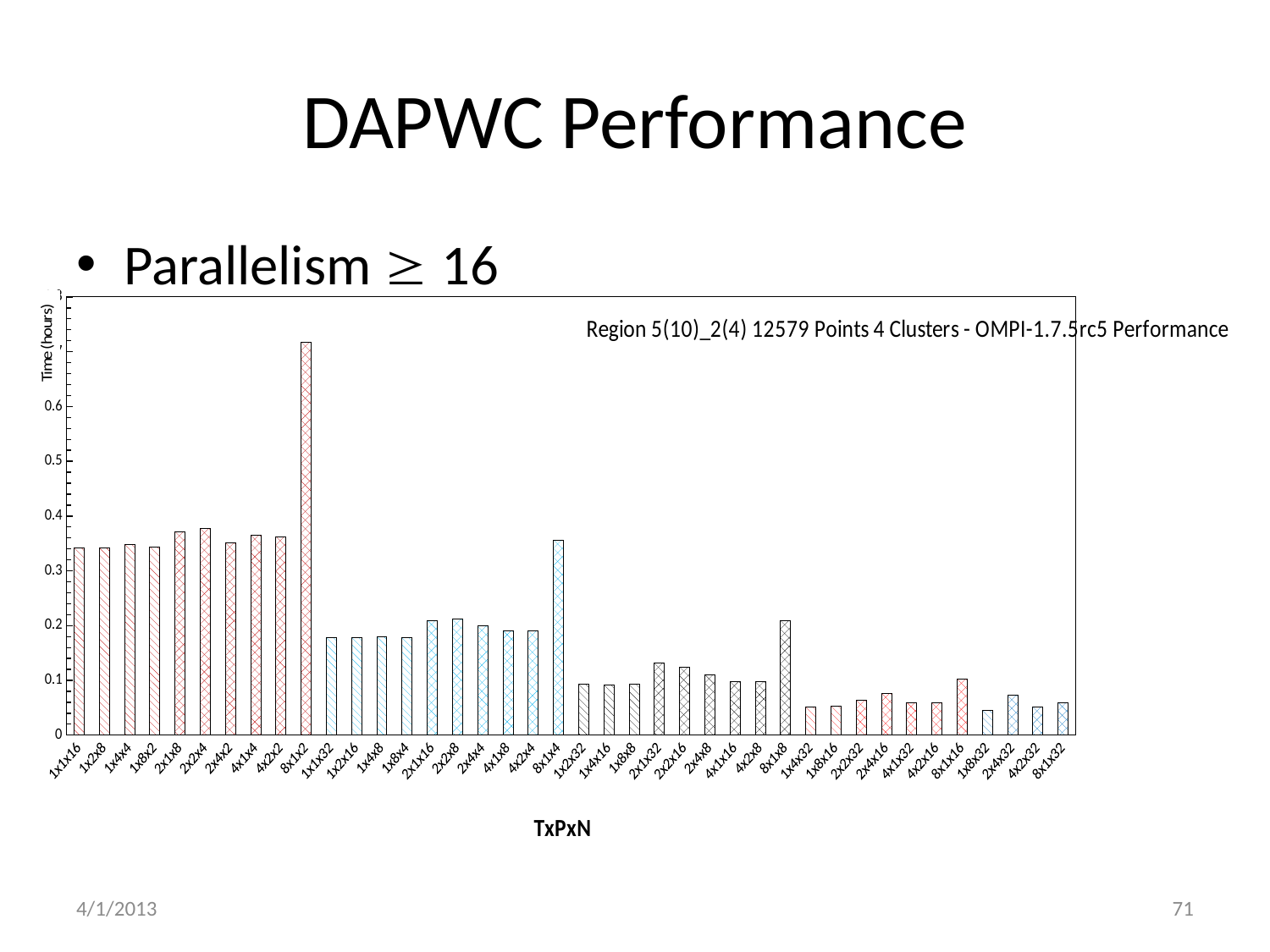
Is the value for 8x1x4 greater or less than 0.3? greater What kind of chart is shown on the slide? bar chart Do the values generally rise or fall moving from left to right along the x axis? fall What is the label of the y axis? Time (hours) Is the value for 1x8x32 greater or less than 0.1? less Is the value for 1x1x16 greater or less than 0.3? greater How many categories are plotted along the x axis? 40 Which is larger, the value for 8x1x2 or the value for 8x1x4? 8x1x2 Which is larger, the value for 2x1x16 or the value for 2x1x32? 2x1x16 Which category has the highest value in the chart? 8x1x2